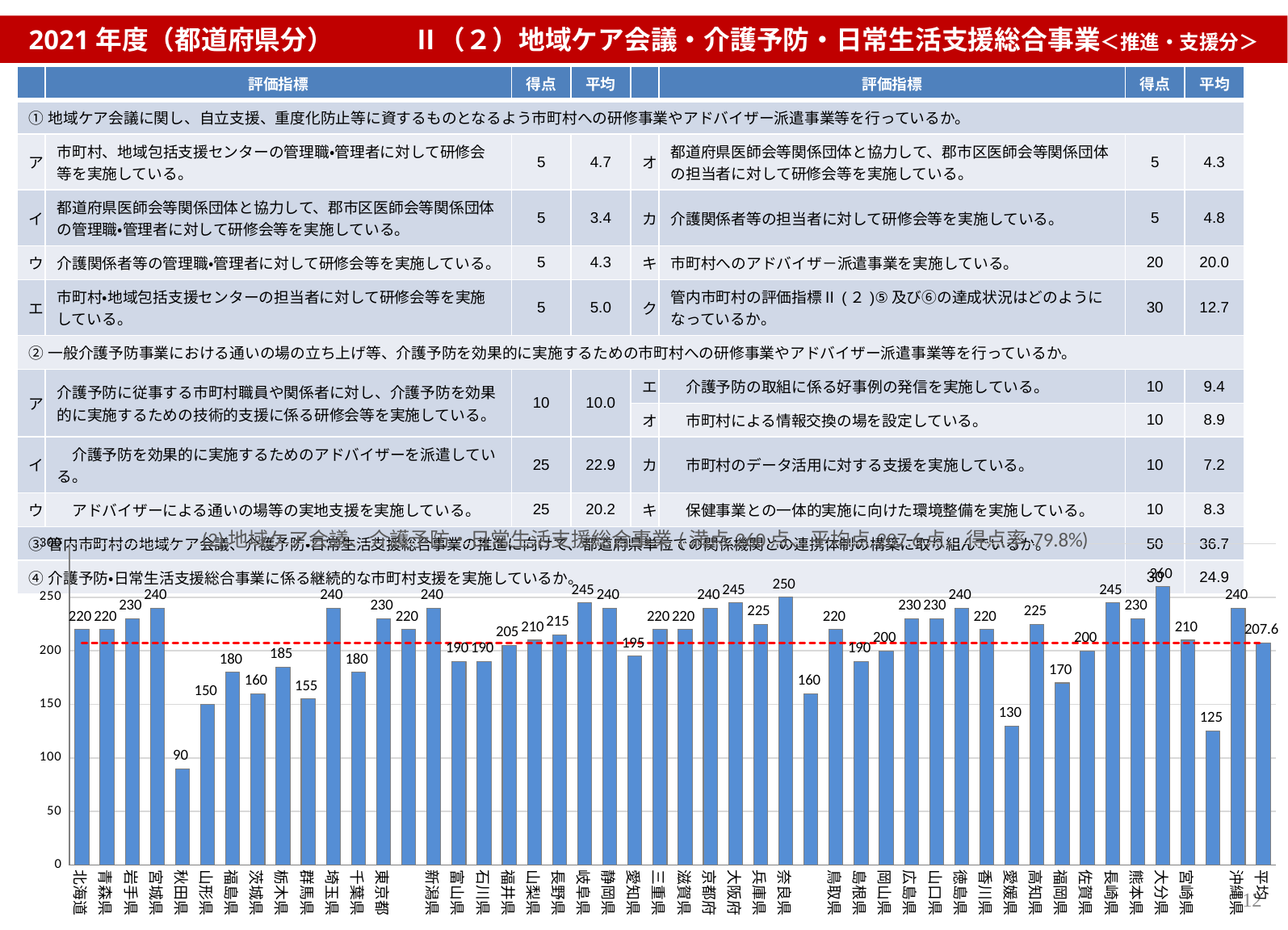
What is the value for 奈良県 in the bar chart? 250 Is the value for 愛媛県 in the bar chart greater or less than 150? less Which has the larger value in the bar chart, 愛媛県 or 福岡県? 福岡県 What is the value for 岐阜県 in the bar chart? 245 Which prefecture has the lowest value in the bar chart? 秋田県 Which prefecture has the highest value in the bar chart? 大分県 What kind of chart is shown at the bottom of the slide? bar chart What value does the horizontal dashed red line in the bar chart mark? 207.6 What is the difference between the values for 宮城県 and 山形県 in the bar chart? 90 What is the value for 秋田県 in the bar chart? 90 What is the difference between the values for 大分県 and 秋田県 in the bar chart? 170 What is the value shown for 平均 (the last bar) in the bar chart? 207.6